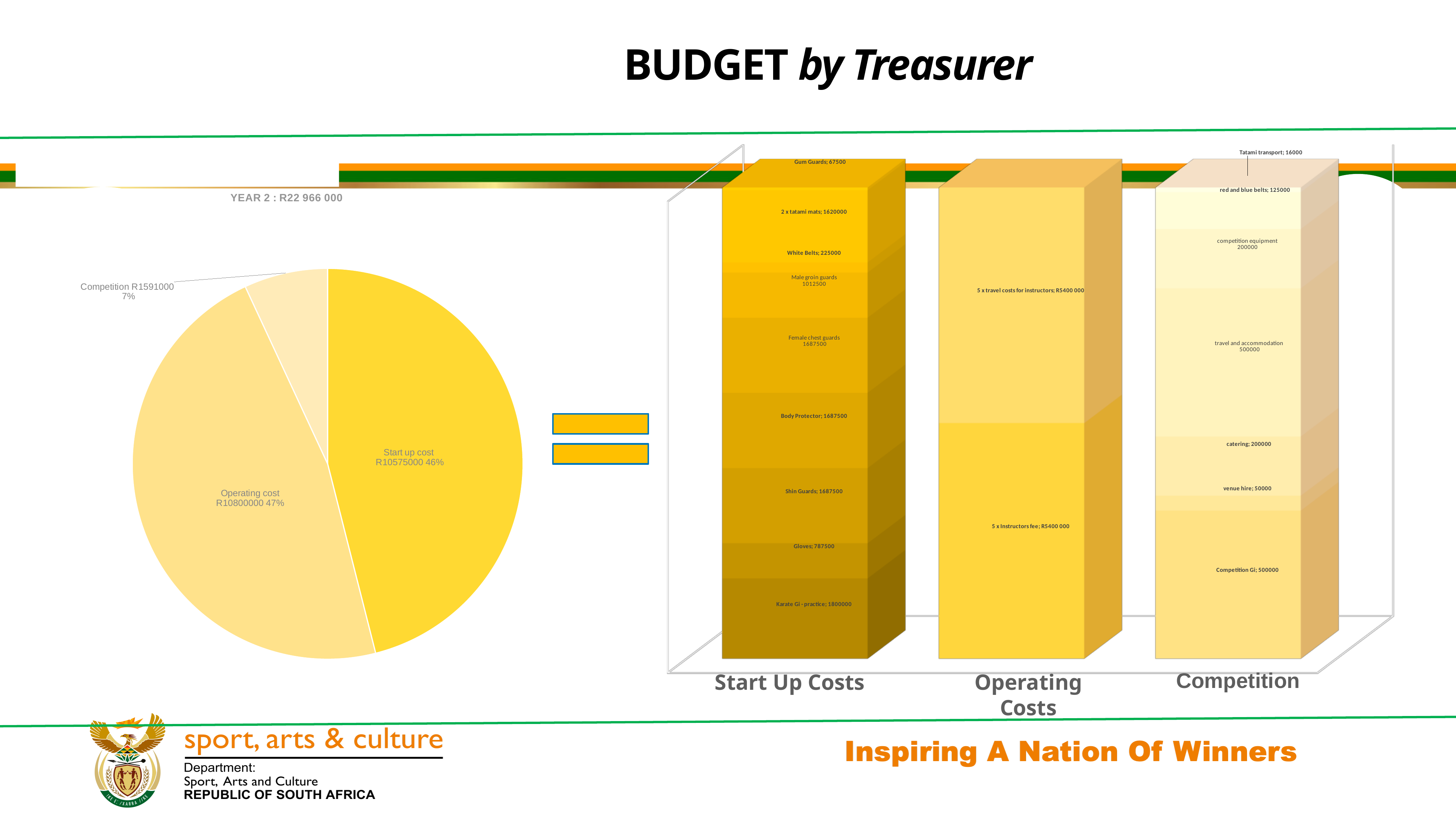
What kind of chart is the chart on the left of the slide? Pie chart What kind of chart is the chart on the right of the slide? Stacked bar chart In the bar chart on the right, how many categories are shown along the x axis? 3 In the bar chart on the right, what is the difference between Karate Gi - practice and 2 x tatami mats in the Start Up Costs bar? 180000 In the bar chart on the right, what is the value for Gloves in the Start Up Costs bar? 787500 In the pie chart on the left, which category has the smallest slice? Competition In the pie chart on the left, what share of the total does Operating cost represent? 47% In the bar chart on the right, what is the value for travel and accommodation in the Competition bar? 500000 In the bar chart on the right, which is larger in the Start Up Costs bar: Gum Guards or White Belts? White Belts How many slices does the pie chart on the left have? 3 In the pie chart on the left, what is the value shown for Competition? R1591000 In the bar chart on the right, what is the value for 5 x Instructors fee in the Operating Costs bar? R5400 000